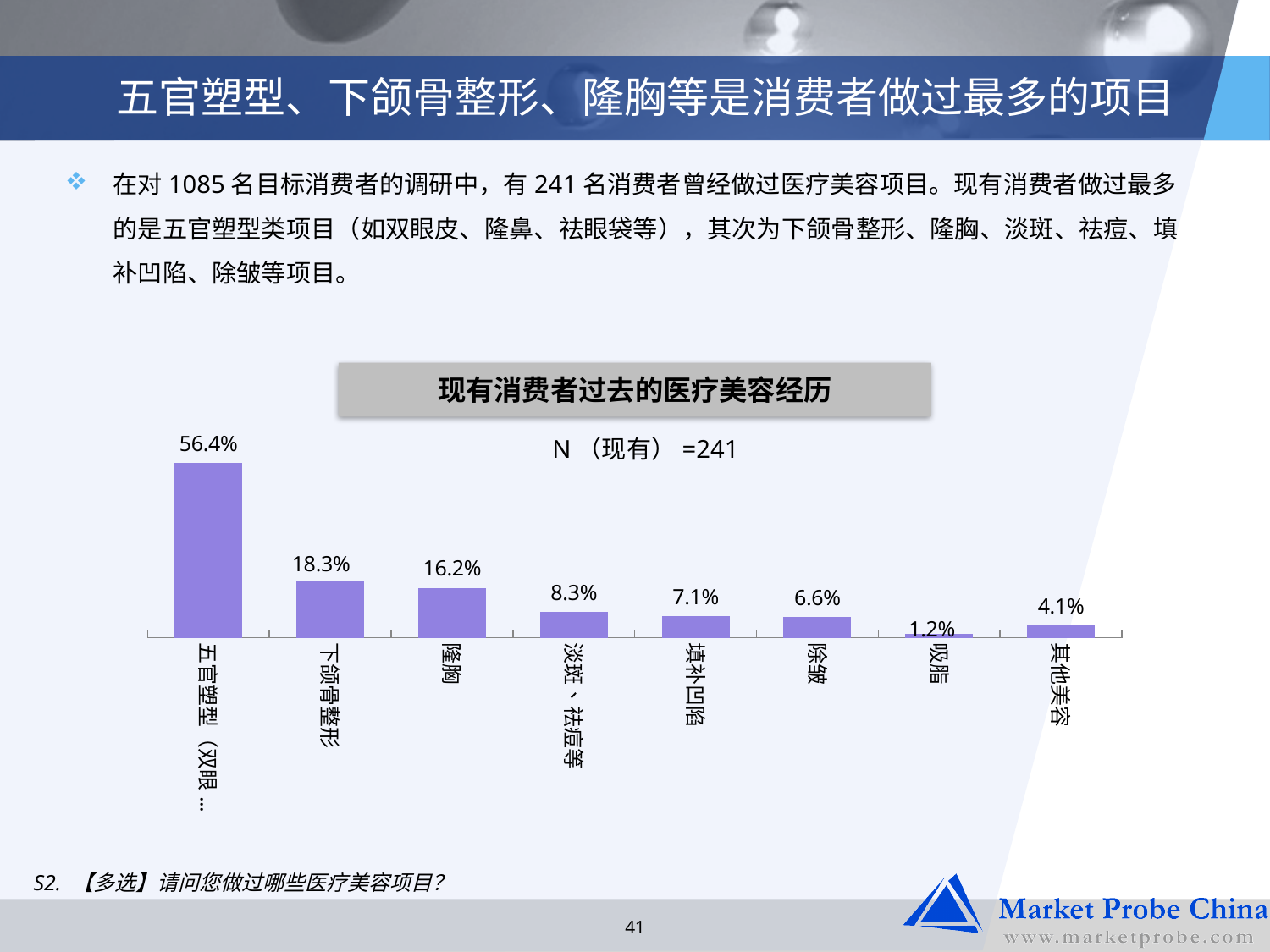
What sample size (N) is stated for the chart? 241 How many categories are shown in the chart? 8 What is the difference between the values for 下颌骨整形 and 隆胸? 2.1% What is the value for 下颌骨整形? 18.3% What type of chart is shown on the slide? Bar chart Which category has the highest value? 五官塑型 What is the value for 吸脂? 1.2% What is the title of the chart? 现有消费者过去的医疗美容经历 What is the value for 隆胸? 16.2% Which category has the lowest value? 吸脂 Which is larger, the value for 除皱 or the value for 其他美容? 除皱 What is the value for 填补凹陷? 7.1%